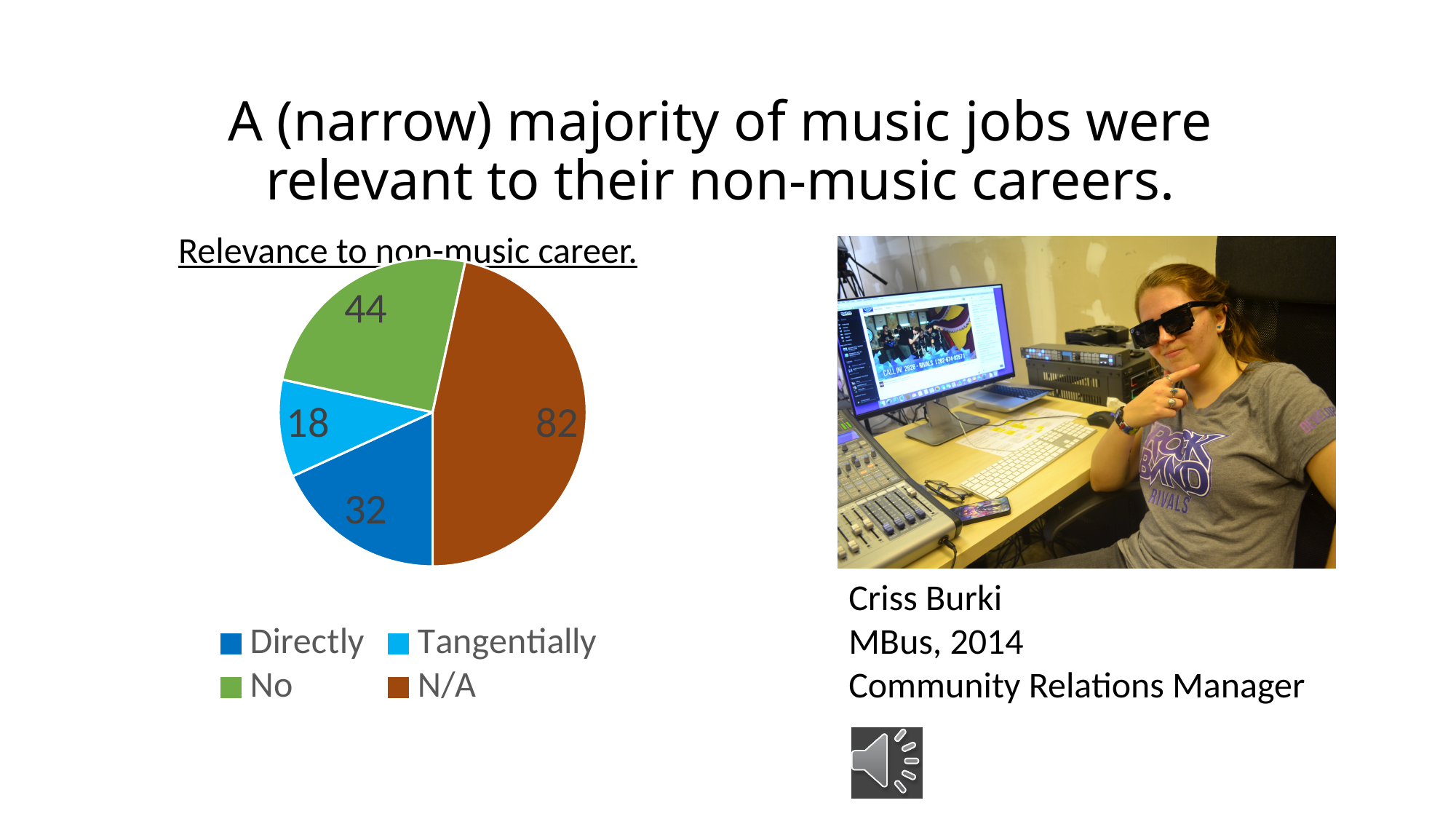
What is the value for the Tangentially slice of the pie chart? 18 What type of chart is shown on the slide? pie chart How many slices does the pie chart have? 4 Which category has the smallest slice of the pie chart? Tangentially Which is larger in the pie chart, Directly or Tangentially? Directly Which category has the largest slice of the pie chart? N/A What is the title of the pie chart? Relevance to non-music career. What is the total of all the slices in the pie chart? 176 What is the value for the N/A slice of the pie chart? 82 What is the value for the Directly slice of the pie chart? 32 What is the difference between the N/A value and the No value in the pie chart? 38 What is the value for the No slice of the pie chart? 44